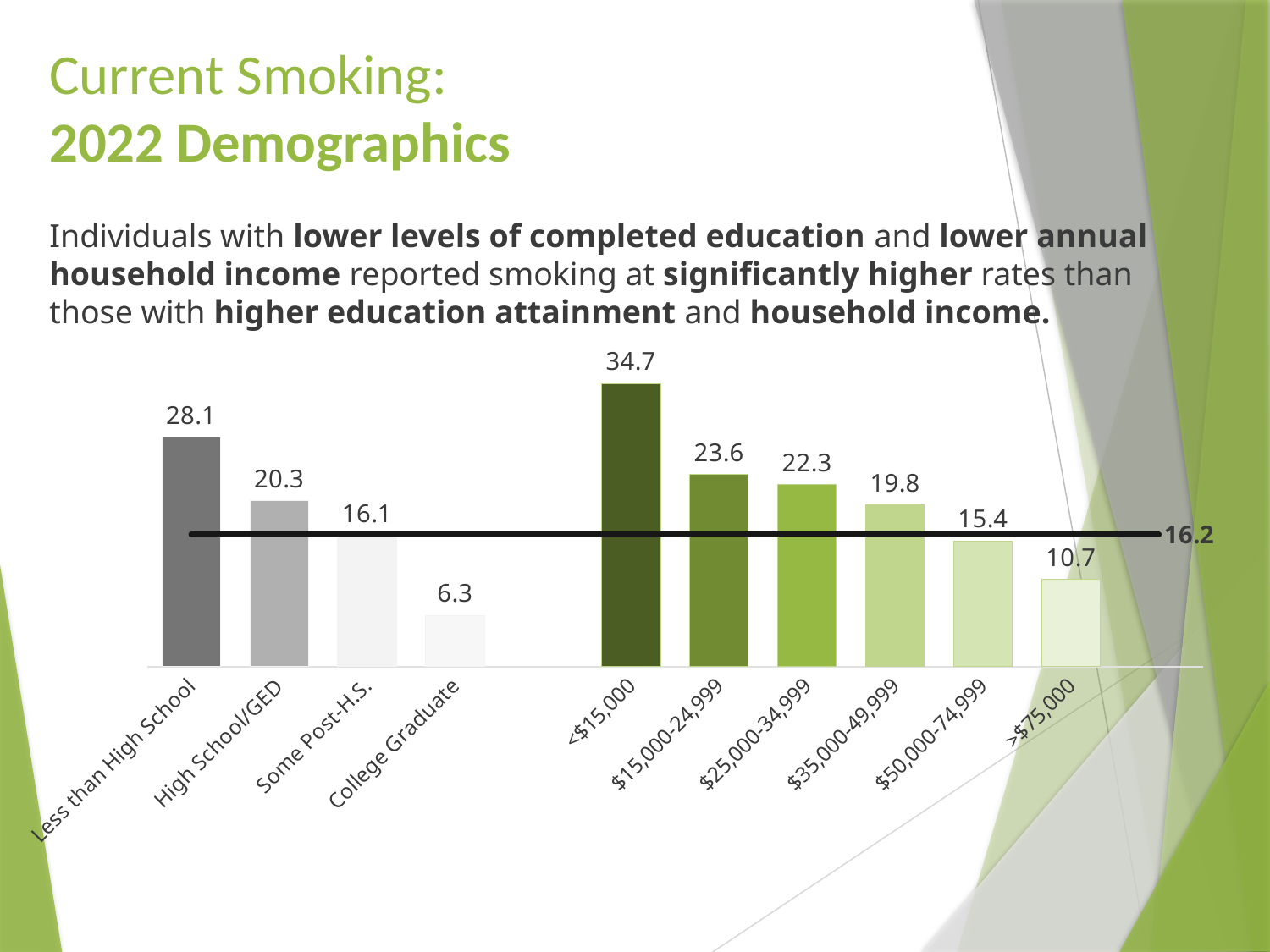
What is the value shown for College Graduate? 6.3 What is the current smoking rate for the Less than High School category? 28.1 What is the difference between the values for <$15,000 and >$75,000? 24.0 What kind of chart is shown on the slide? Bar chart Which category has the lowest bar on the chart? College Graduate What is the value shown for the <$15,000 income group? 34.7 Which category has the highest bar on the chart? <$15,000 Which is larger, the value for $15,000-24,999 or the value for $25,000-34,999? $15,000-24,999 How many bars are plotted on the chart? 10 What is the difference between the values for Less than High School and High School/GED? 7.8 What value does the horizontal reference line across the chart mark? 16.2 Do the values fall or rise as income increases from <$15,000 to >$75,000? Fall